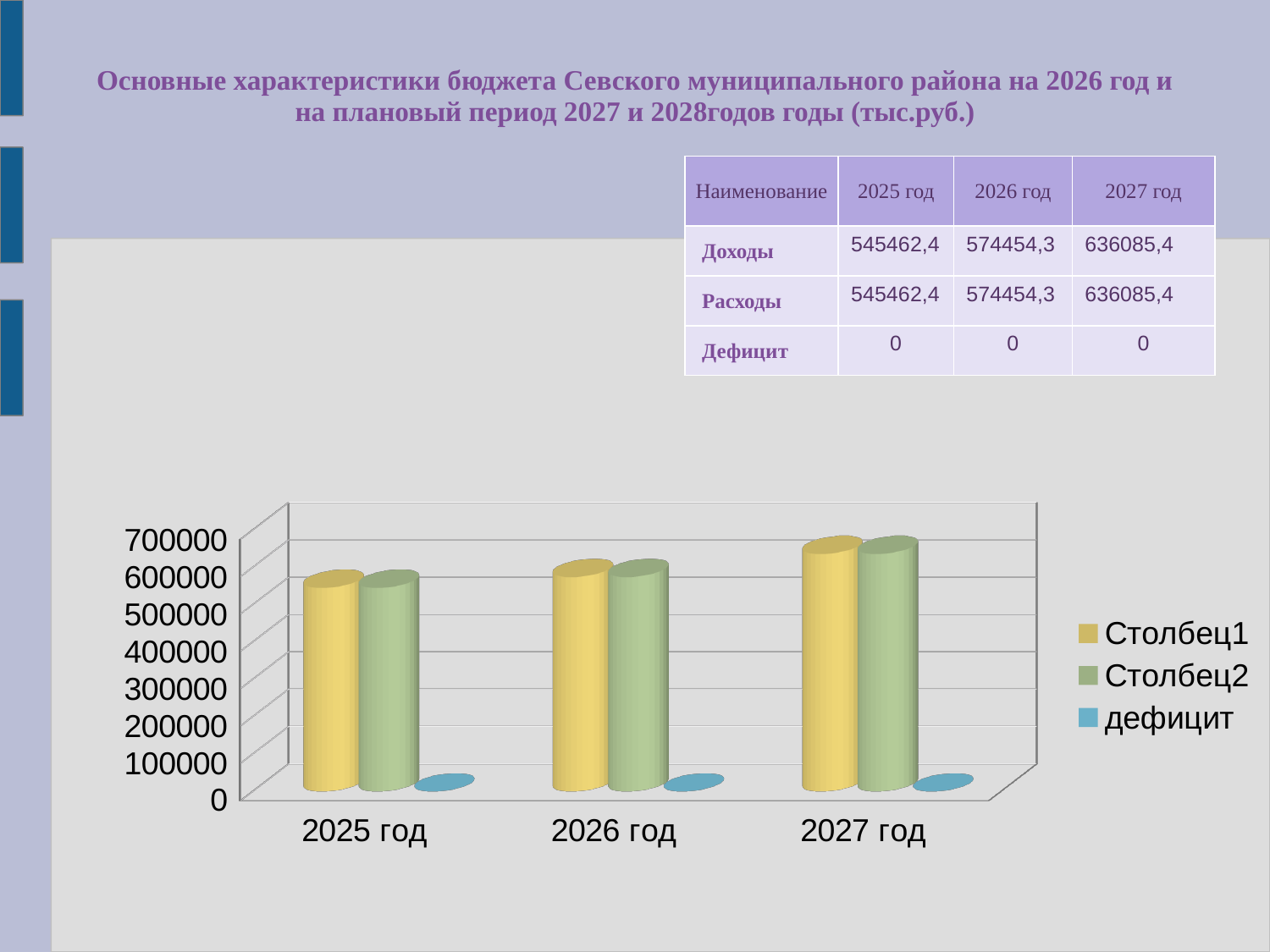
Which year has the highest value for Столбец1 in the chart? 2027 год Do the values for Столбец1 rise or fall from 2025 год to 2027 год? rise Which series in the chart legend is shown in blue? дефицит What kind of chart is shown on the slide? bar chart Which is larger in the chart: Столбец1 for 2027 год or Столбец1 for 2025 год? 2027 год How many series does the chart legend list? 3 Is the value for Столбец2 in 2027 год greater or less than 600000? greater Which year has the lowest value for Столбец2 in the chart? 2025 год Is the value for Столбец2 in 2027 год greater or less than 700000? less Is the value for Столбец1 in 2025 год greater or less than 600000? less How many year categories are shown on the x axis of the chart? 3